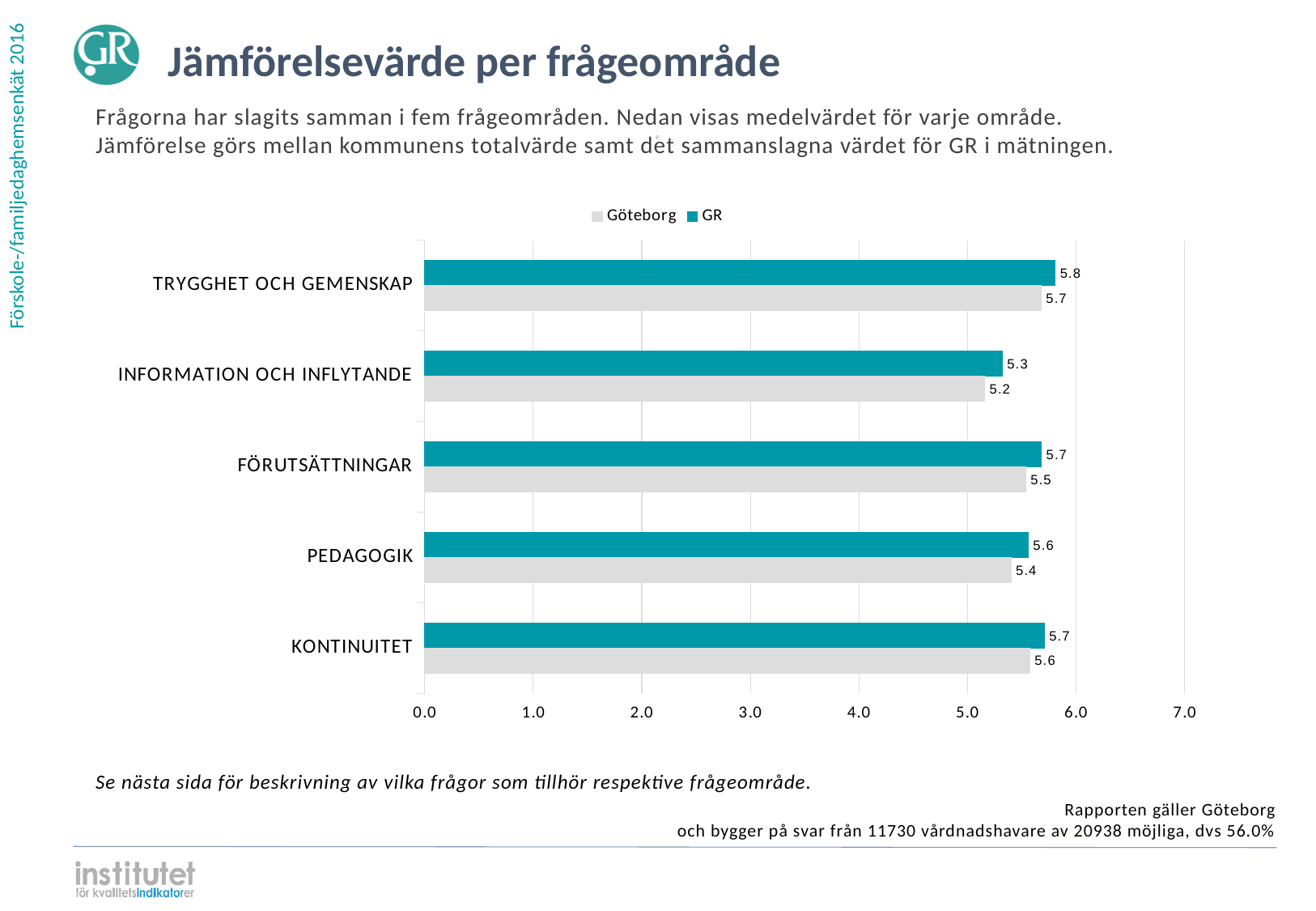
Which category has the lowest Göteborg value? Information och inflytande Which category has the highest GR value? Trygghet och gemenskap What is the GR value for Trygghet och gemenskap? 5.8 Which is larger for Pedagogik, the GR value or the Göteborg value? GR What kind of chart is shown on the slide? Bar chart How many series does the legend list? 2 What is the Göteborg value for Pedagogik? 5.4 What is the difference between the Göteborg values for Trygghet och gemenskap and Information och inflytande? 0.5 How many categories (frågeområden) are shown in the chart? 5 What is the difference between the GR and Göteborg values for Förutsättningar? 0.2 What is the GR value for Kontinuitet? 5.7 What is the Göteborg value for Information och inflytande? 5.2